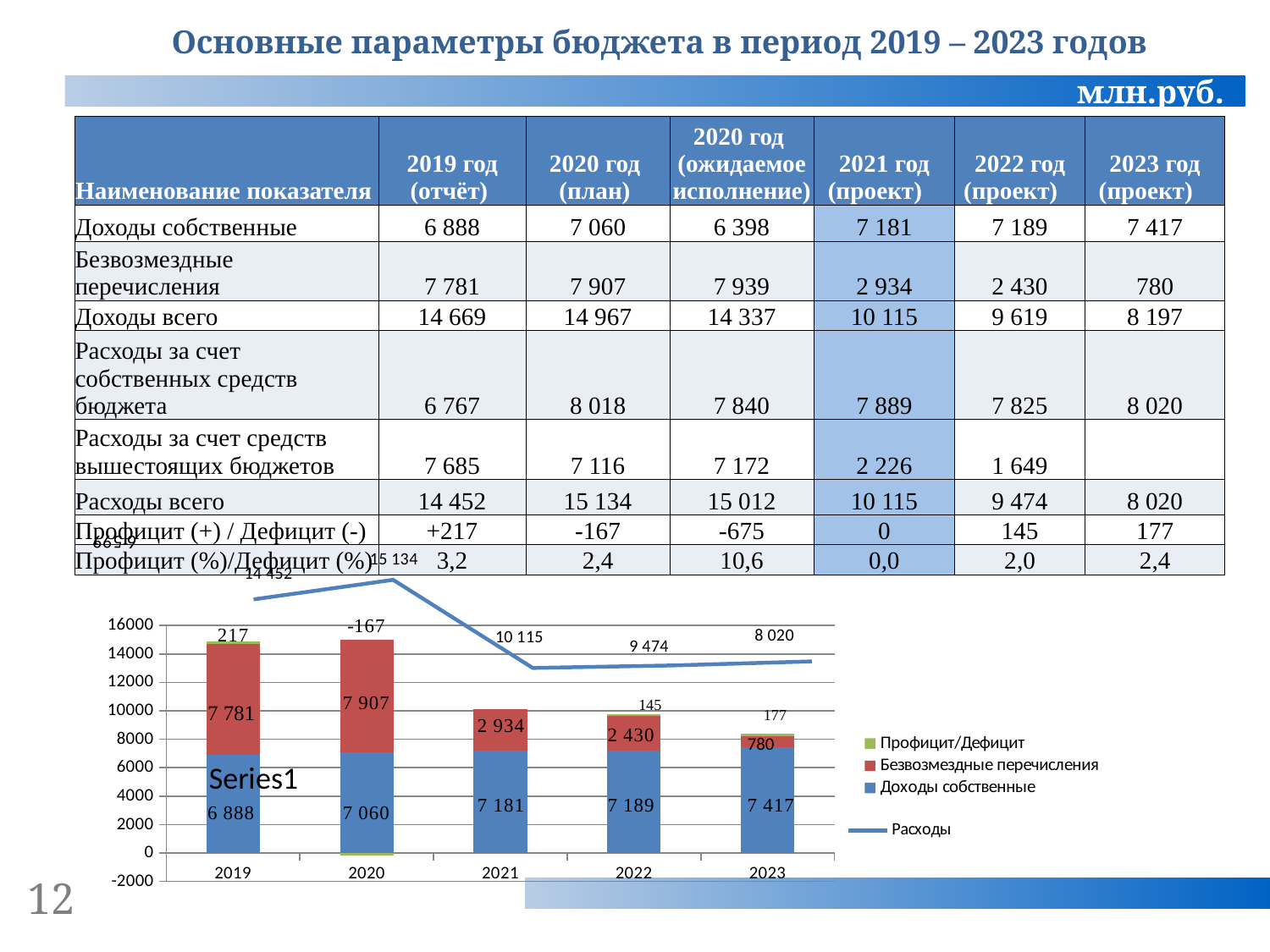
In the chart, what is the value of Профицит/Дефицит for 2020? -167 In the chart, does the Расходы line rise or fall from 2020 to 2023? Fall In the chart, what is the value of Безвозмездные перечисления for 2021? 2 934 How many series does the chart legend list? 4 What kind of chart is shown at the bottom of the slide? Stacked bar chart with a line In the chart, which year has the lowest value of Безвозмездные перечисления? 2023 In the chart, which year has the highest value of the Расходы line? 2020 In the chart, what is the value of Доходы собственные for 2023? 7 417 In the chart, is Безвозмездные перечисления larger in 2020 or in 2022? 2020 In the chart, what is the value of the Расходы line for 2022? 9 474 In the chart, what is the difference between Доходы собственные in 2023 and in 2019? 529 How many years are shown on the x axis of the chart? 5